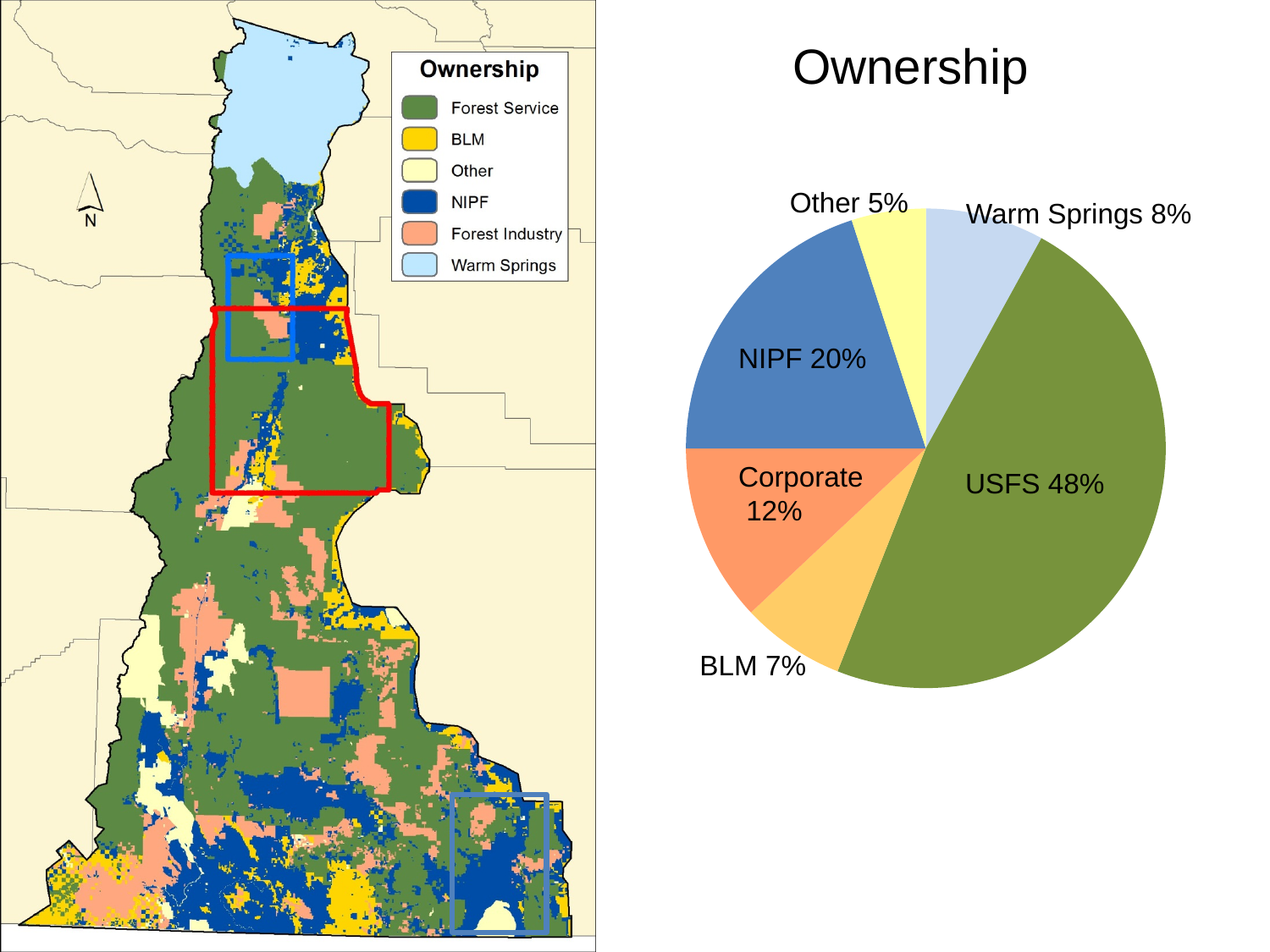
What percentage does Warm Springs account for in the Ownership pie chart? 8% Which category has the largest slice in the Ownership pie chart? USFS What is the Corporate share in the Ownership pie chart? 12% What percentage of the Ownership pie chart is NIPF? 20% In the Ownership pie chart, which is larger: Warm Springs or BLM? Warm Springs How many slices does the Ownership pie chart have? 6 In the Ownership pie chart, what is the difference between the Corporate and BLM shares? 5% What share of the Ownership pie chart does USFS hold? 48% What type of chart is the Ownership chart on the right of the slide? Pie chart Which category has the smallest slice in the Ownership pie chart? Other In the Ownership pie chart, how many percentage points larger is USFS than NIPF? 28 What is the title of the chart on the right side of the slide? Ownership